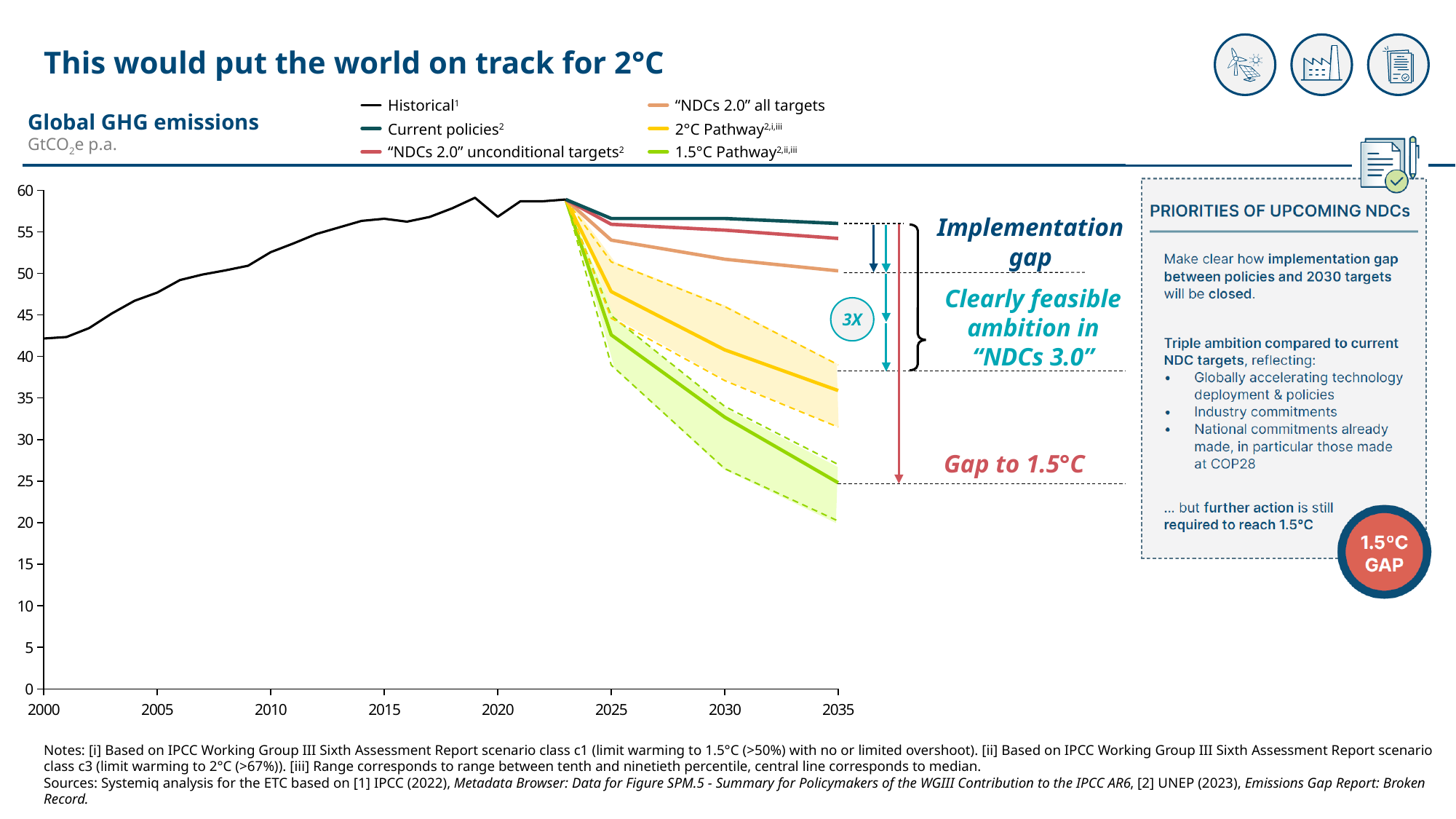
In 2035, which is larger: the Current policies value or the 1.5°C Pathway value? Current policies Is the Historical value in 2000 greater or less than 40? greater What kind of chart is shown on the slide? Line chart Which series has the lowest value in 2035? 1.5°C Pathway How many series does the chart legend list? 6 What is the title of the chart? Global GHG emissions Is the Current policies value in 2035 greater or less than 55? greater What unit is the chart's y axis measured in? GtCO2e p.a. Does the Historical series rise or fall between 2000 and 2020? Rise Which series has the highest value in 2035? Current policies Is the 1.5°C Pathway value in 2035 greater or less than 30? less